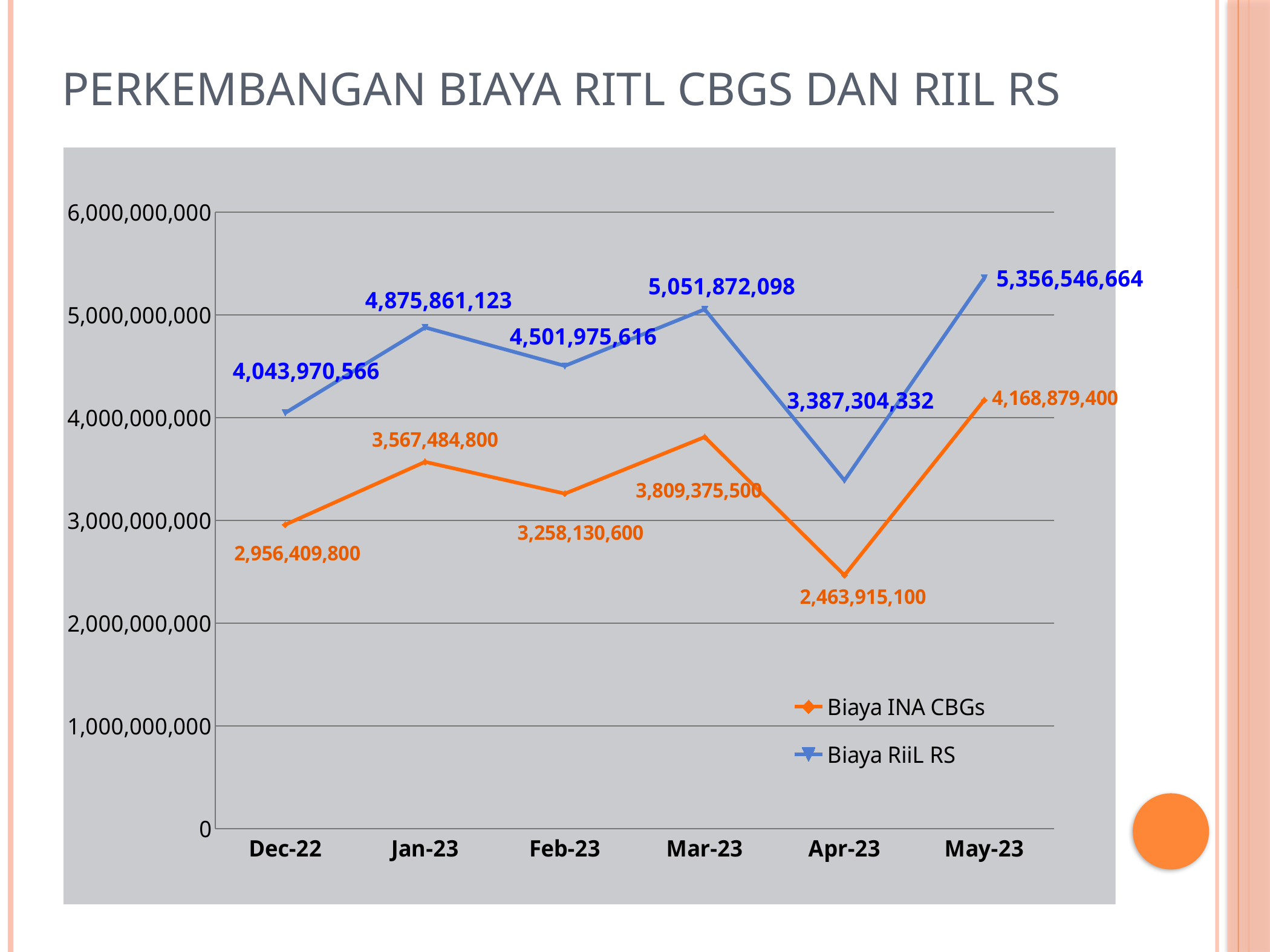
What is the value of Biaya INA CBGs for Apr-23? 2,463,915,100 Does Biaya INA CBGs rise or fall from Mar-23 to Apr-23? Fall In which month is Biaya RiiL RS highest? May-23 What colour is the Biaya RiiL RS line? Blue What is the difference between Biaya RiiL RS and Biaya INA CBGs in May-23? 1,187,667,264 What is the value of Biaya RiiL RS for Mar-23? 5,051,872,098 What type of chart is shown on the slide? Line chart How many months are plotted on the x axis? 6 What is the value of Biaya INA CBGs for Dec-22? 2,956,409,800 In which month is Biaya INA CBGs lowest? Apr-23 How many series does the legend list? 2 Which is larger in Feb-23, Biaya INA CBGs or Biaya RiiL RS? Biaya RiiL RS